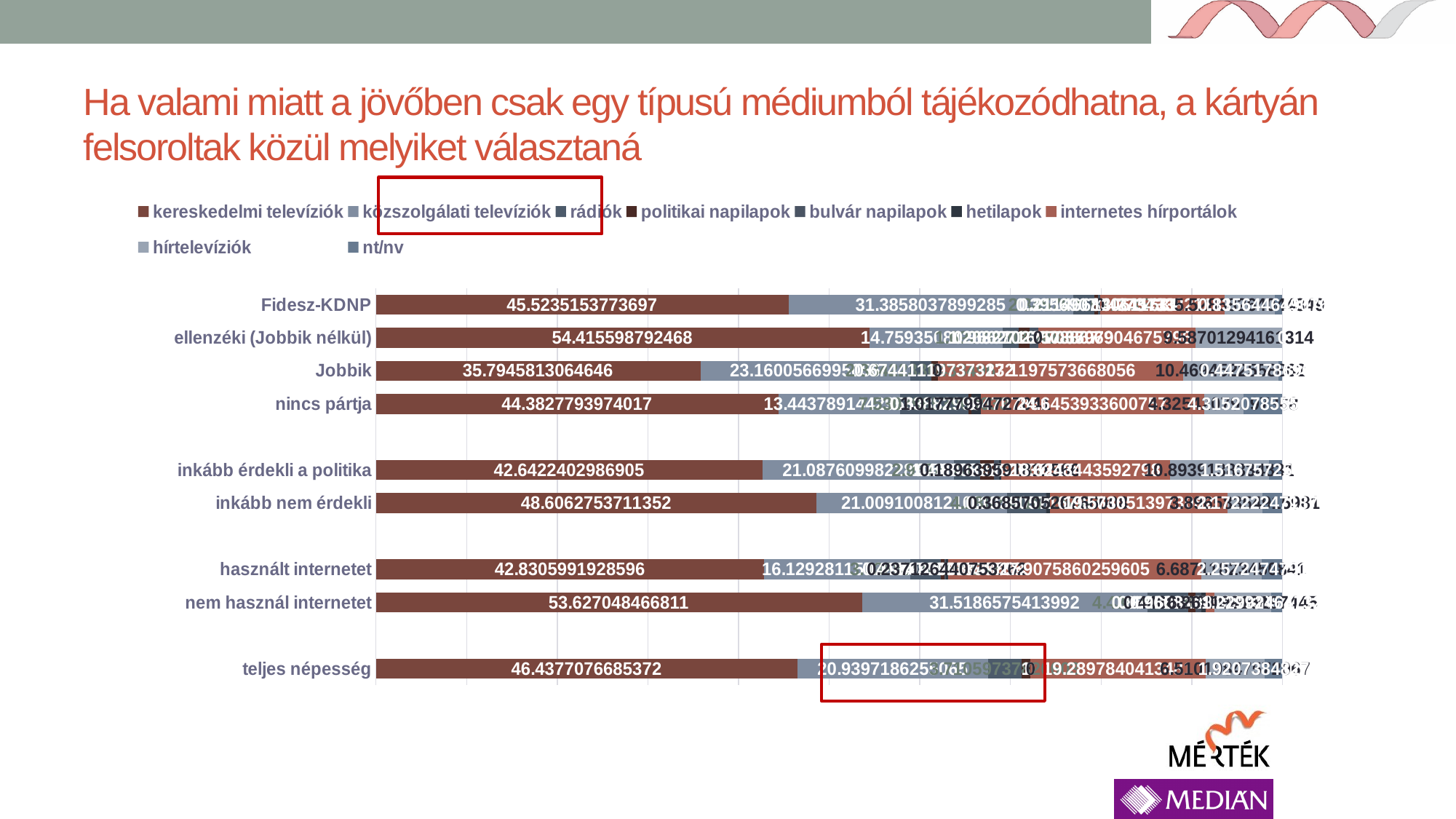
What is the difference between the kereskedelmi televíziók values for ellenzéki (Jobbik nélkül) and Jobbik? 18.6210174860034 Which series is listed first in the legend? kereskedelmi televíziók Which category has the highest value for kereskedelmi televíziók? ellenzéki (Jobbik nélkül) In the Fidesz-KDNP row, which is larger: the value for kereskedelmi televíziók or for közszolgálati televíziók? kereskedelmi televíziók Which category has the lowest value for kereskedelmi televíziók? Jobbik How many series does the legend list? 9 What is the value for kereskedelmi televíziók in the teljes népesség row? 46.4377076685372 What is the value for kereskedelmi televíziók in the Fidesz-KDNP row? 45.5235153773697 How many categories (rows) are plotted in the chart? 9 What is the value for közszolgálati televíziók in the Fidesz-KDNP row? 31.3858037899285 What is the value for kereskedelmi televíziók in the nem használ internetet row? 53.627048466811 What kind of chart is shown on the slide? stacked bar chart